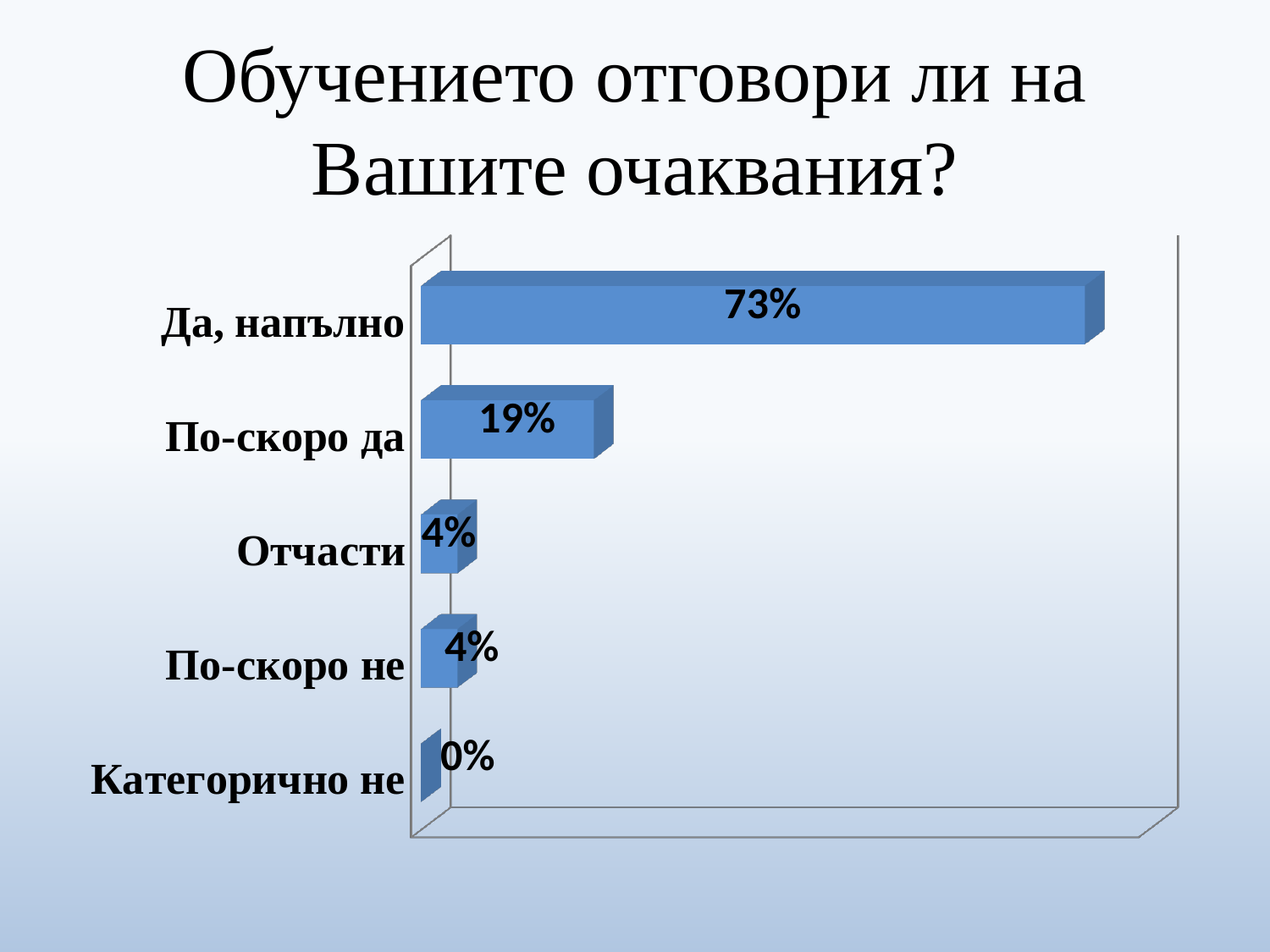
Which category has the highest value? Да, напълно Which category has the lowest value? Категорично не What kind of chart is shown on the slide? Bar chart How many categories are shown in the chart? 5 What is the value for "Да, напълно"? 73% What is the value for "Отчасти"? 4% What is the difference between the values for "Да, напълно" and "По-скоро да"? 54% What colour are the bars in the chart? Blue What is the title of the slide? Обучението отговори ли на Вашите очаквания? Which is larger, the value for "По-скоро да" or the value for "По-скоро не"? По-скоро да What is the value for "По-скоро да"? 19% What is the value for "Категорично не"? 0%